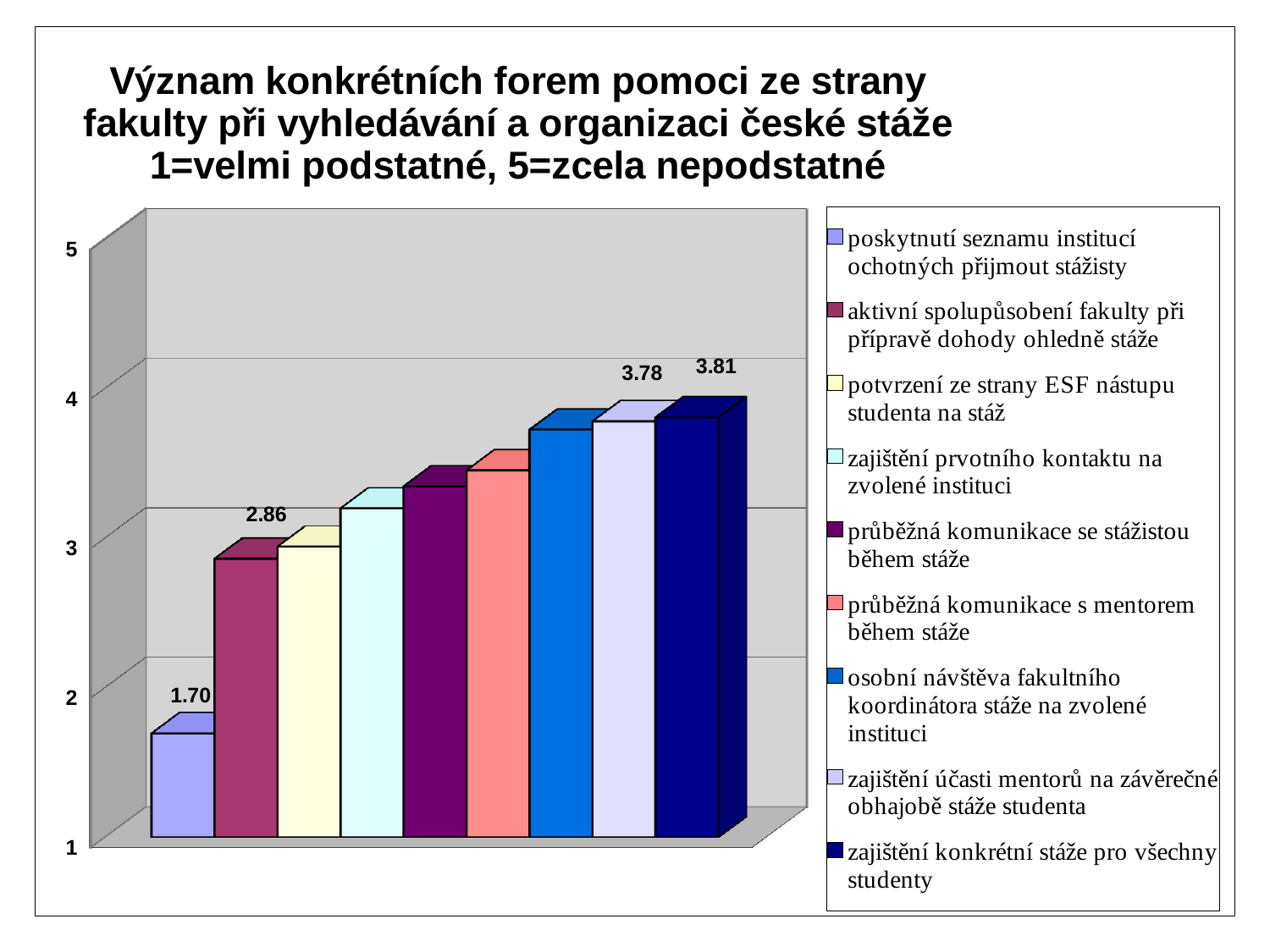
Which form of help has the lowest value? poskytnutí seznamu institucí ochotných přijmout stážisty What kind of chart is shown on the slide? bar chart What is the value for 'zajištění konkrétní stáže pro všechny studenty'? 3.81 How many bars are plotted in the chart? 9 Which is larger: the value for 'poskytnutí seznamu institucí ochotných přijmout stážisty' or for 'aktivní spolupůsobení fakulty při přípravě dohody ohledně stáže'? aktivní spolupůsobení fakulty při přípravě dohody ohledně stáže What is the difference between the values for 'zajištění konkrétní stáže pro všechny studenty' and 'poskytnutí seznamu institucí ochotných přijmout stážisty'? 2.11 Which form of help has the highest value? zajištění konkrétní stáže pro všechny studenty Is the value for 'průběžná komunikace se stážistou během stáže' greater or less than 3? greater Is the value for 'osobní návštěva fakultního koordinátora stáže na zvolené instituci' greater or less than 4? less What is the value for 'zajištění účasti mentorů na závěrečné obhajobě stáže studenta'? 3.78 What is the value for 'poskytnutí seznamu institucí ochotných přijmout stážisty'? 1.70 What is the value for 'aktivní spolupůsobení fakulty při přípravě dohody ohledně stáže'? 2.86